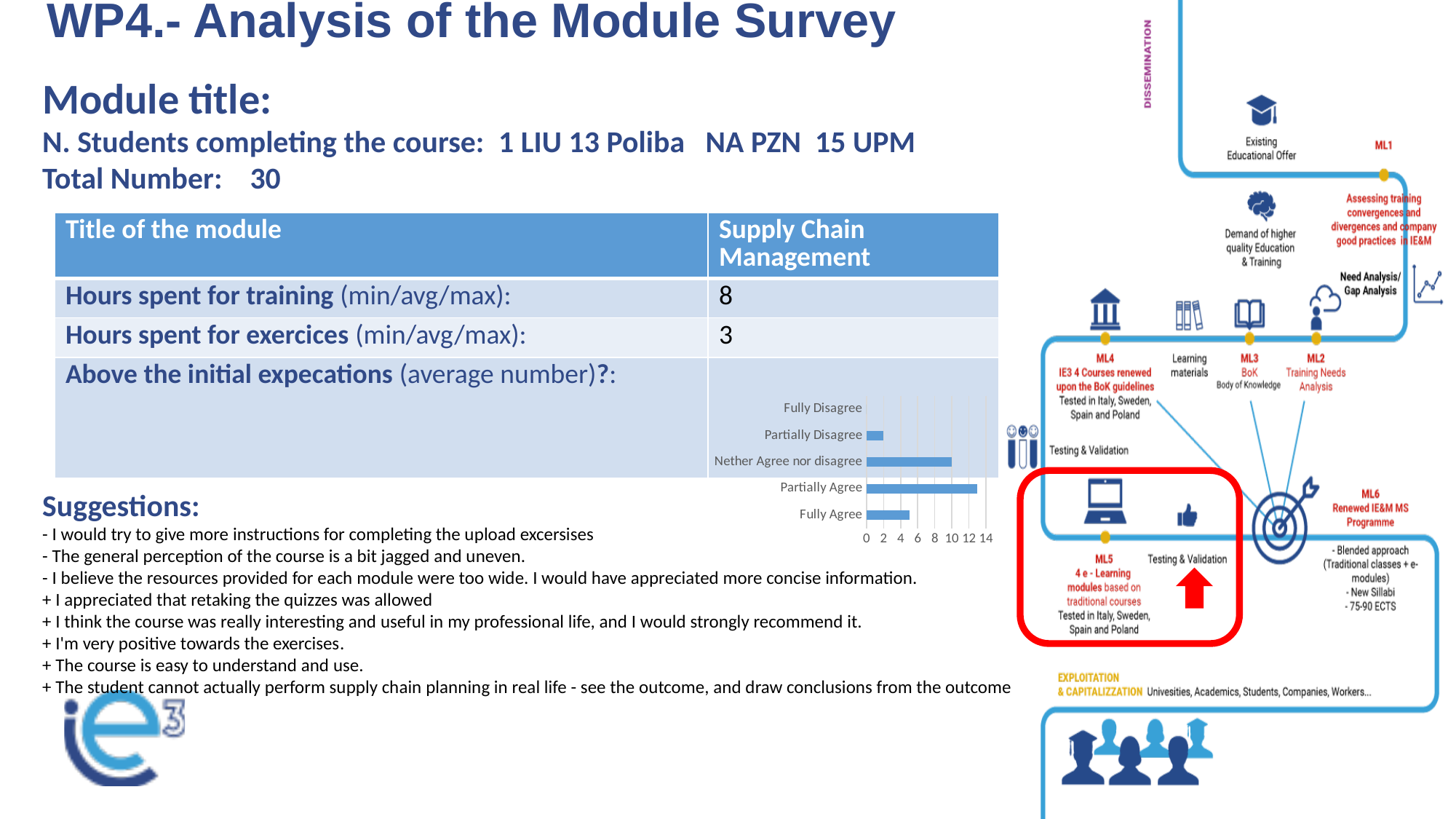
Is the value for Nether Agree nor disagree greater or less than 6? greater Is the value for Fully Agree greater or less than 8? less Which has a larger value: Nether Agree nor disagree or Fully Agree? Nether Agree nor disagree Which response category has the lowest value in the bar chart? Fully Disagree Are the bars in the chart drawn horizontally or vertically? horizontally Which response category has the highest value in the bar chart? Partially Agree What is the highest tick value shown on the chart's value axis? 14 How many response categories does the bar chart show? 5 Which has a larger value: Partially Disagree or Fully Agree? Fully Agree Is the value for Partially Agree greater or less than 10? greater What kind of chart is shown on the slide? bar chart